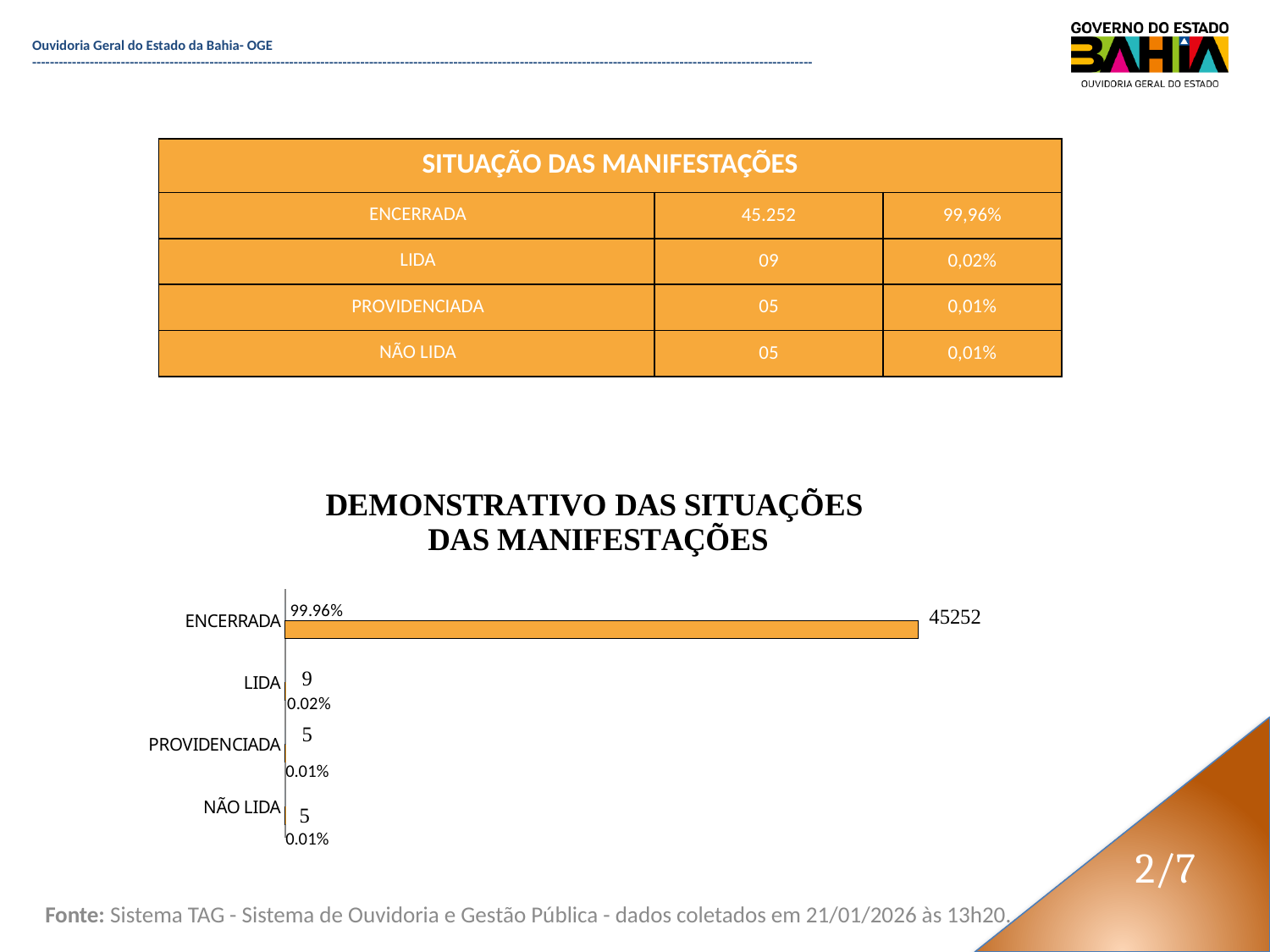
What is the title of the bar chart on the slide? DEMONSTRATIVO DAS SITUAÇÕES DAS MANIFESTAÇÕES In the bar chart, what is the value labelled for LIDA? 9 In the bar chart, what percentage is labelled for ENCERRADA? 99.96% In the bar chart, what is the value labelled for PROVIDENCIADA? 5 In the bar chart, what is the difference between the values for ENCERRADA and LIDA? 45243 In the bar chart, what percentage is labelled for LIDA? 0.02% In the bar chart, what is the value labelled for ENCERRADA? 45252 In the bar chart, what percentage is labelled for NÃO LIDA? 0.01% In the bar chart, which is larger, the value for LIDA or the value for PROVIDENCIADA? LIDA In the bar chart, how many categories are shown on the vertical axis? 4 What kind of chart is shown under the title 'DEMONSTRATIVO DAS SITUAÇÕES DAS MANIFESTAÇÕES'? Bar chart In the bar chart, which category has the highest value? ENCERRADA